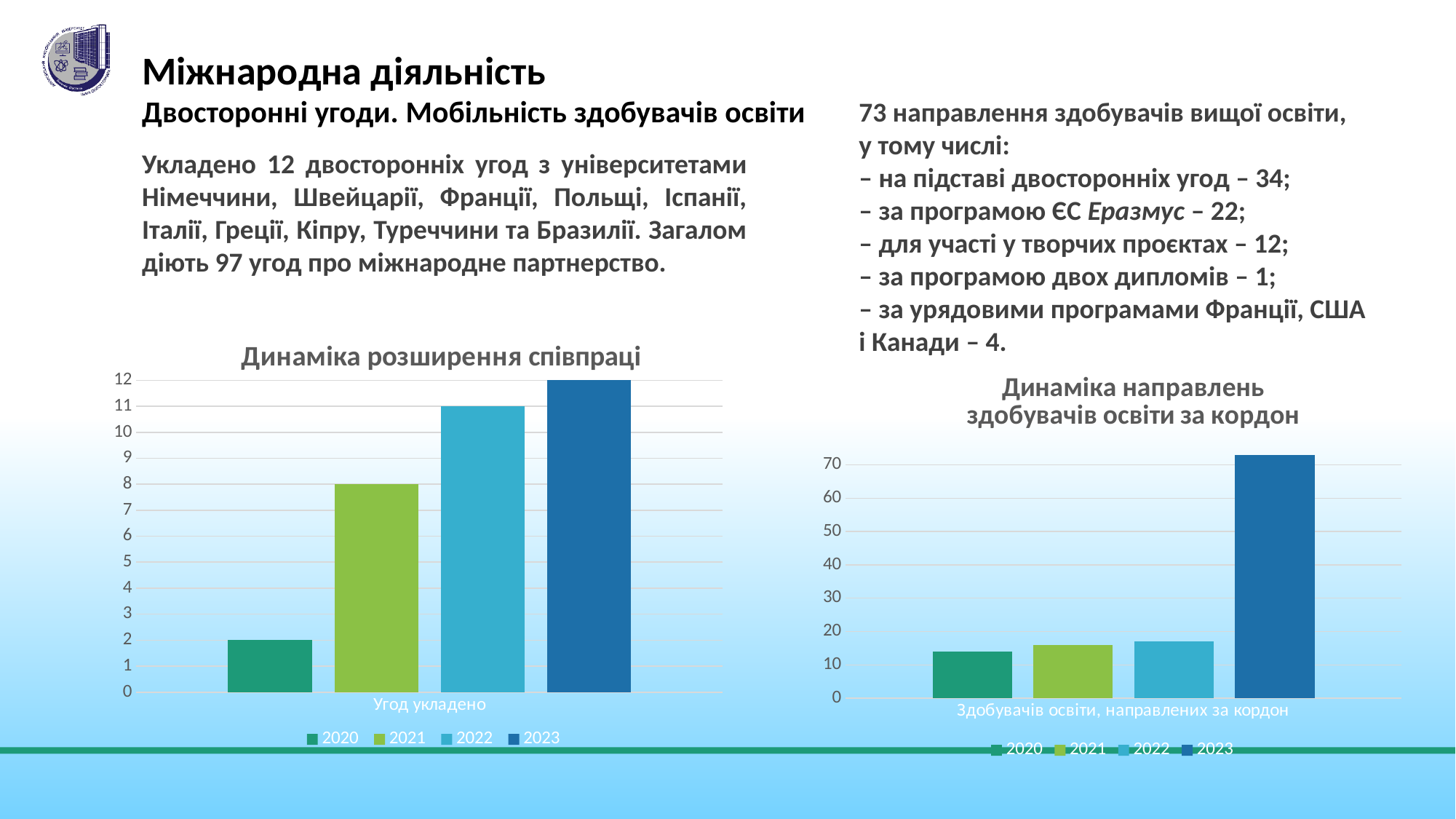
In the chart titled "Динаміка розширення співпраці", which year has the highest value? 2023 How many series does the legend of the chart titled "Динаміка направлень здобувачів освіти за кордон" list? 4 What kind of chart is the chart titled "Динаміка розширення співпраці"? bar chart In the chart titled "Динаміка направлень здобувачів освіти за кордон", is the value for 2023 greater or less than 70? greater In the chart titled "Динаміка розширення співпраці", what is the difference between the values for 2022 and 2021? 3 In the chart titled "Динаміка розширення співпраці", what is the value for 2020? 2 In the chart titled "Динаміка направлень здобувачів освіти за кордон", is the value for 2020 greater or less than 20? less In the chart titled "Динаміка розширення співпраці", what is the value for 2023? 12 In the chart titled "Динаміка розширення співпраці", which year has the lowest value? 2020 In the chart titled "Динаміка направлень здобувачів освіти за кордон", which year has the highest value? 2023 In the chart titled "Динаміка розширення співпраці", do the values rise or fall from 2020 to 2023? rise In the chart titled "Динаміка розширення співпраці", what is the value for 2021? 8